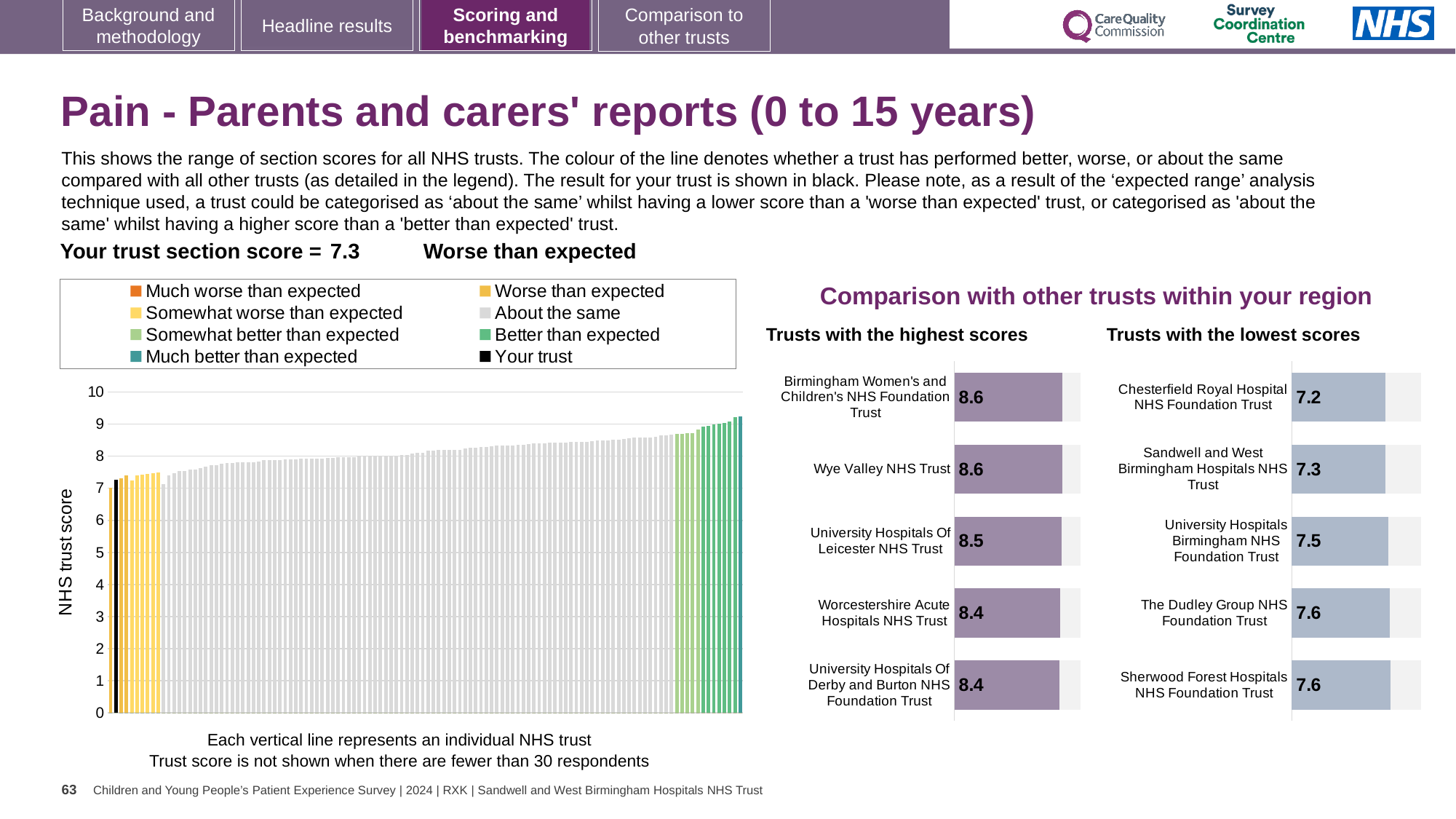
What kind of chart is the large chart on the left showing all NHS trusts? Bar chart How many trusts are shown in the 'Trusts with the highest scores' chart? 5 In the 'Trusts with the lowest scores' chart, what is the score for University Hospitals Birmingham NHS Foundation Trust? 7.5 In the chart on the left, what is the label on the vertical axis? NHS trust score In the chart on the left, is the value for the black 'Your trust' bar greater or less than 8? less How many entries does the legend above the left-hand chart list? 8 In the 'Trusts with the highest scores' chart, what is the difference between the scores of Birmingham Women's and Children's NHS Foundation Trust and Worcestershire Acute Hospitals NHS Trust? 0.2 In the 'Trusts with the highest scores' chart, what is the score for University Hospitals Of Leicester NHS Trust? 8.5 In the 'Trusts with the lowest scores' chart, which has the larger score: The Dudley Group NHS Foundation Trust or Sandwell and West Birmingham Hospitals NHS Trust? The Dudley Group NHS Foundation Trust In the 'Trusts with the highest scores' chart, what is the score for Wye Valley NHS Trust? 8.6 In the 'Trusts with the lowest scores' chart, which trust has the lowest score? Chesterfield Royal Hospital NHS Foundation Trust In the chart on the left, do the trust scores rise or fall from left to right along the x axis? Rise